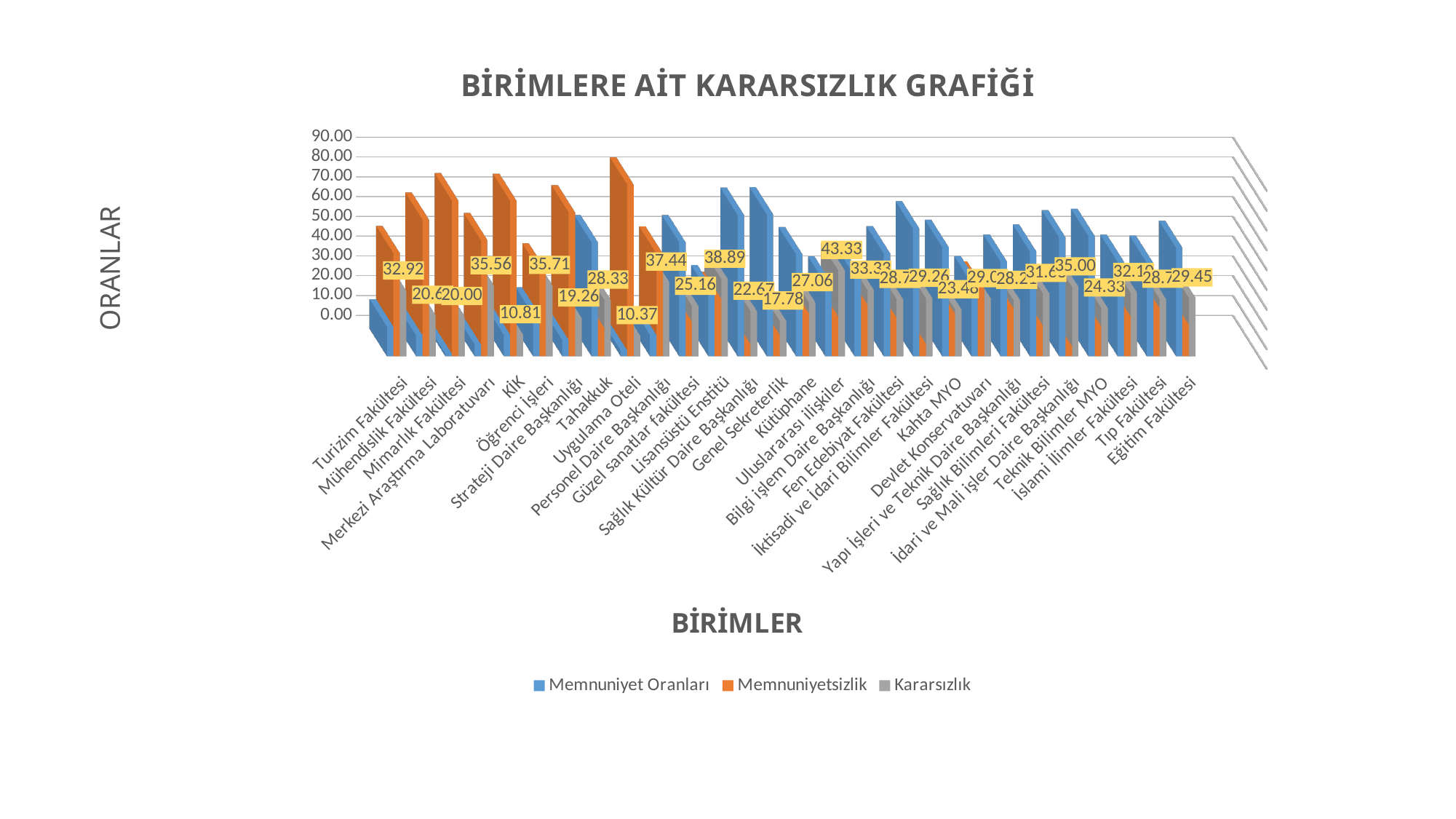
What type of chart is shown on the slide? bar chart What is the title of the chart? BİRİMLERE AİT KARARSIZLIK GRAFİĞİ How many units (categories) are shown on the x axis? 28 Which unit has the lowest Kararsızlık value? Uygulama Oteli How many series does the legend list? 3 What is the Kararsızlık value for Turizim Fakültesi? 32.92 Which has a larger Kararsızlık value, Personel Daire Başkanlığı or Güzel sanatlar fakültesi? Personel Daire Başkanlığı What is the difference between the Kararsızlık values of Lisansüstü Enstitü and Genel Sekreterlik? 21.11 Which unit has the highest Kararsızlık value? Uluslararası ilişkiler What is the Kararsızlık value for Uygulama Oteli? 10.37 Is the Memnuniyetsizlik value for Tahakkuk greater or less than 70.00? less What is the Kararsızlık value for Uluslararası ilişkiler? 43.33